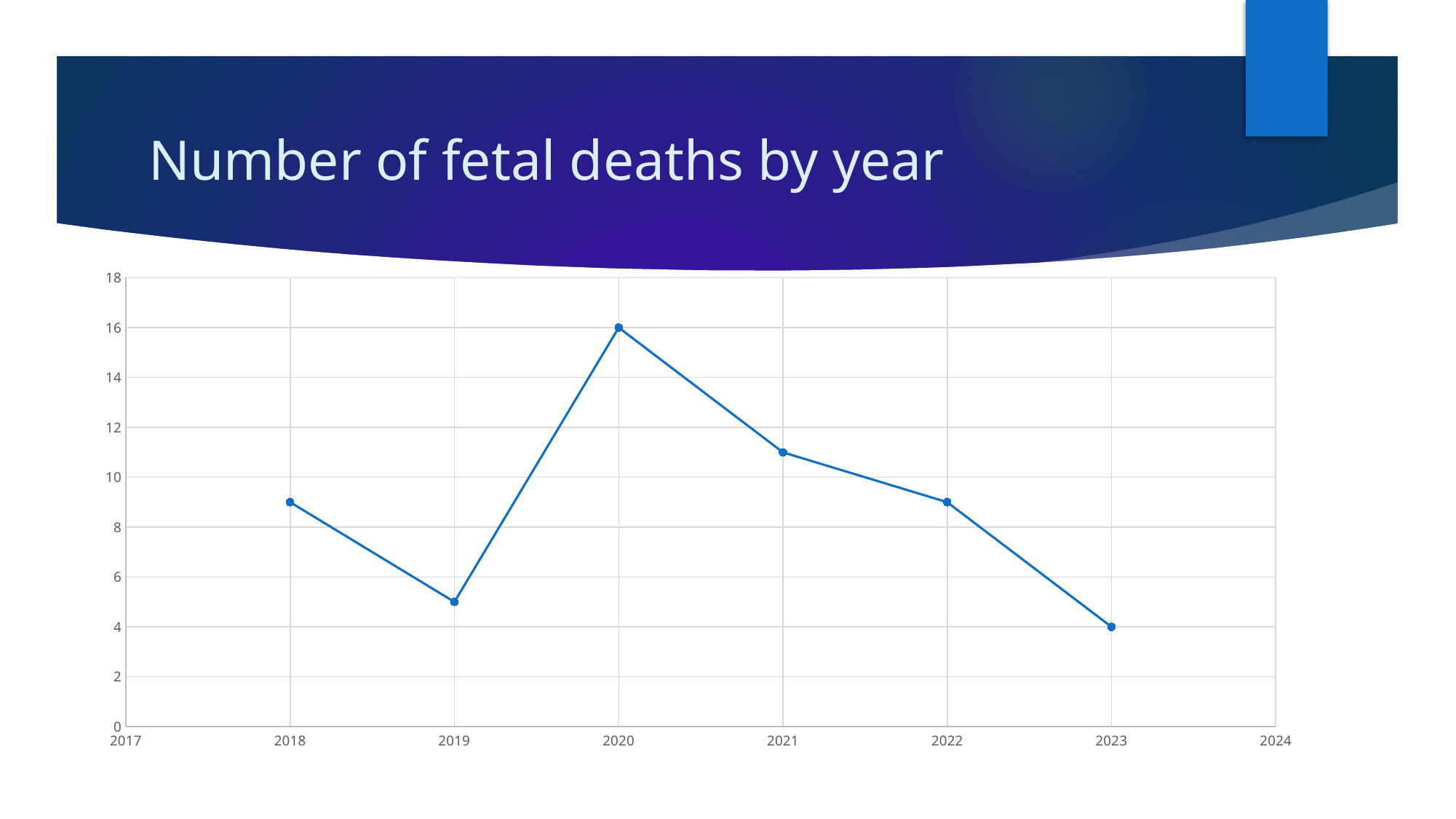
Which year has the lowest number of fetal deaths? 2023 Which year has more fetal deaths, 2018 or 2019? 2018 What is the number of fetal deaths in 2020? 16 What is the difference between the number of fetal deaths in 2020 and in 2023? 12 Which year has the highest number of fetal deaths? 2020 What is the title of the chart? Number of fetal deaths by year What is the number of fetal deaths in 2023? 4 Is the value for 2019 greater or less than 6? less Is the value for 2018 greater or less than 8? greater Is the value for 2021 greater or less than 10? greater How many data points are plotted on the chart? 6 What type of chart is shown on the slide? line chart